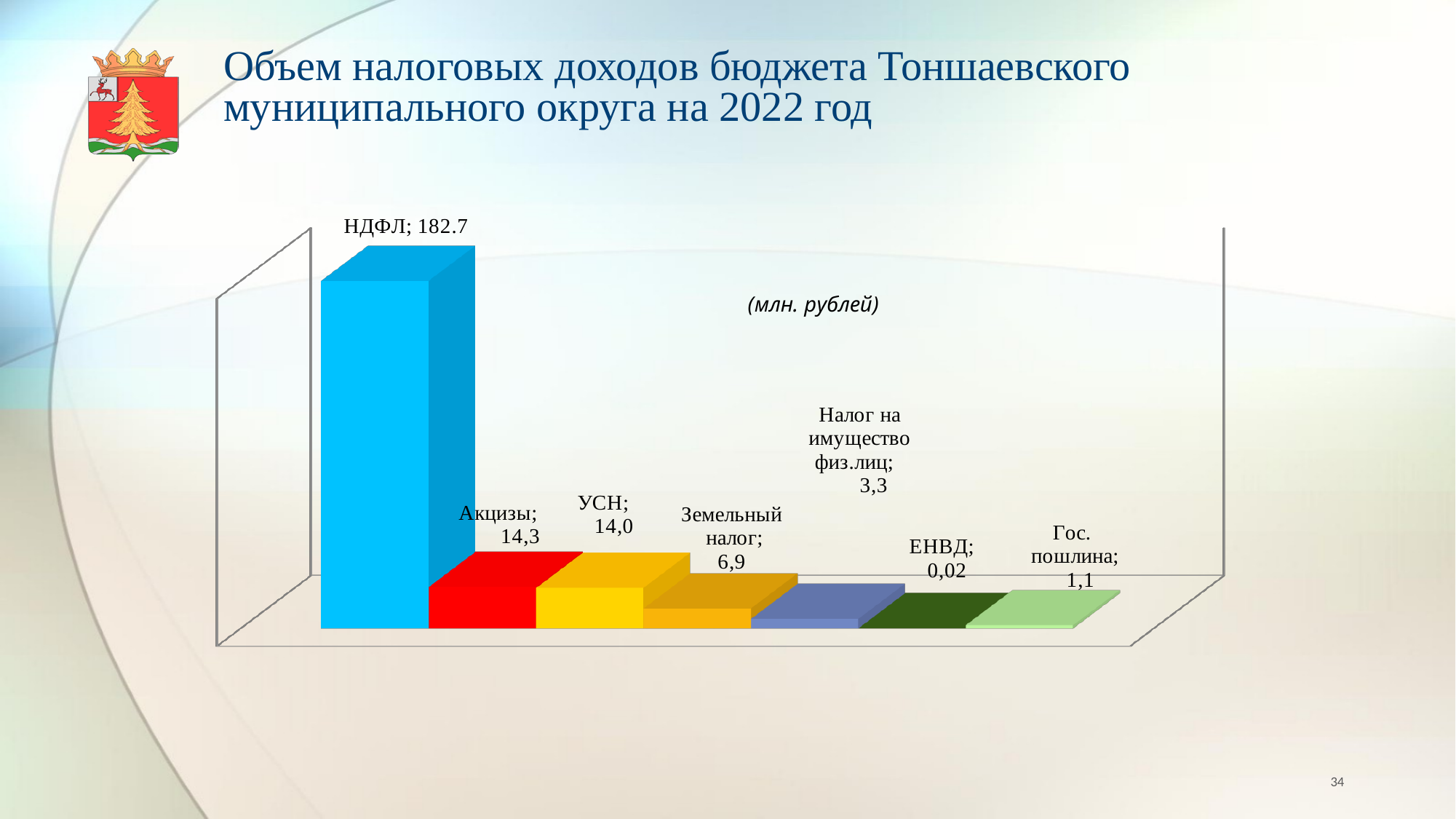
Which is larger, the value for Налог на имущество физ.лиц or the value for Гос. пошлина? Налог на имущество физ.лиц Which category has the highest value? НДФЛ Which category has the lowest value? ЕНВД What is the value for Земельный налог? 6,9 What is the difference between the values for Акцизы and Земельный налог? 7,4 What is the value for Налог на имущество физ.лиц? 3,3 What is the value for УСН? 14,0 What is the value for Гос. пошлина? 1,1 How many categories are shown in the chart? 7 What is the value for ЕНВД? 0,02 What is the value for НДФЛ? 182.7 What is the value for Акцизы? 14,3